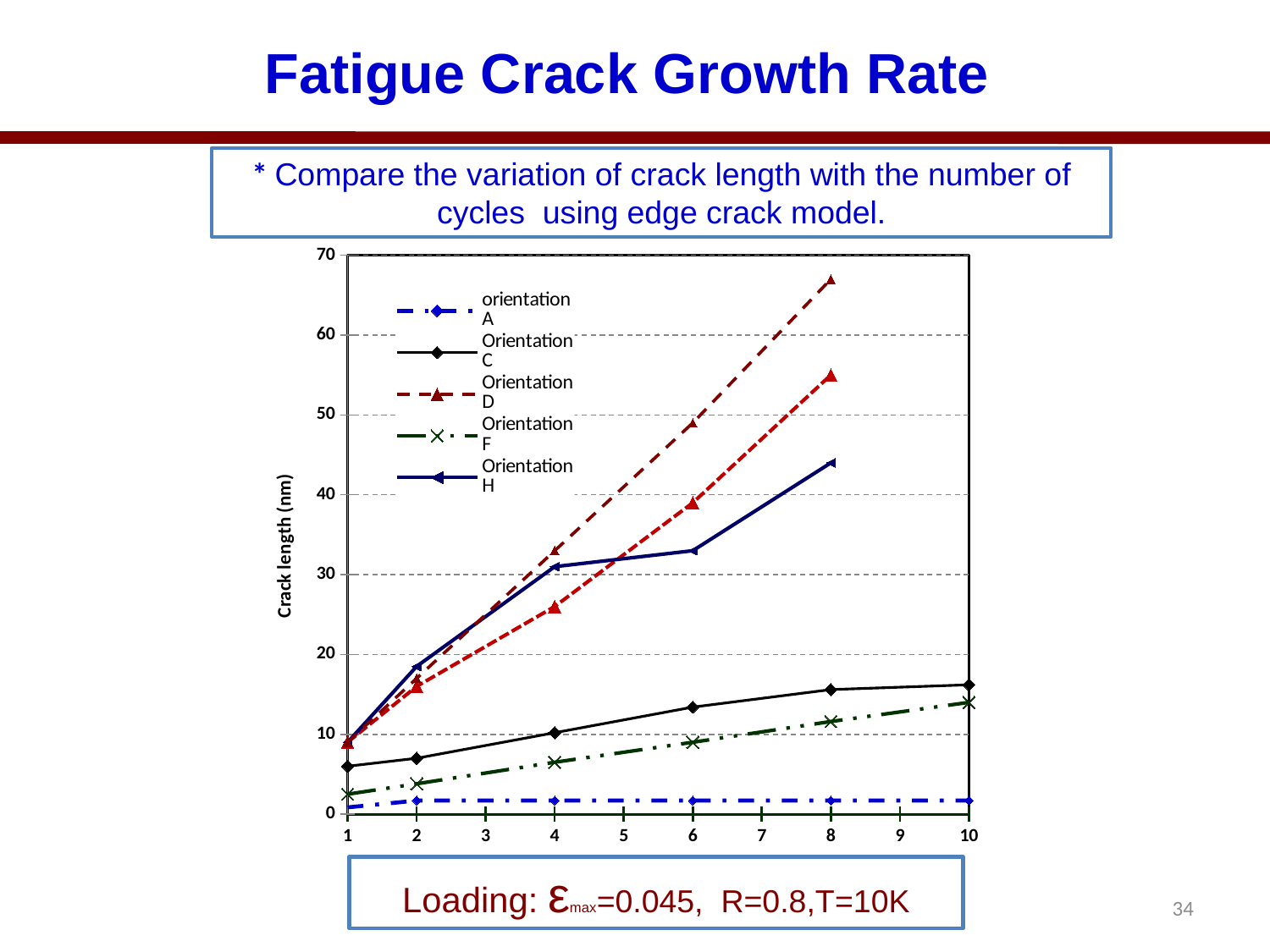
What is the title of the y axis? Crack length (nm) Is the value for Orientation F at x = 2 greater or less than 10? less How many series does the legend list? 5 Do the values for Orientation C rise or fall along the x axis? rise Is the value for Orientation H at x = 8 greater or less than 40? greater At x = 6, which is larger: Orientation C or Orientation F? Orientation C Is the value for Orientation C at x = 10 greater or less than 10? greater At x = 8, which is larger: Orientation H or Orientation C? Orientation H What kind of chart is shown on the slide? line chart Which series is lowest at x = 10? orientation A